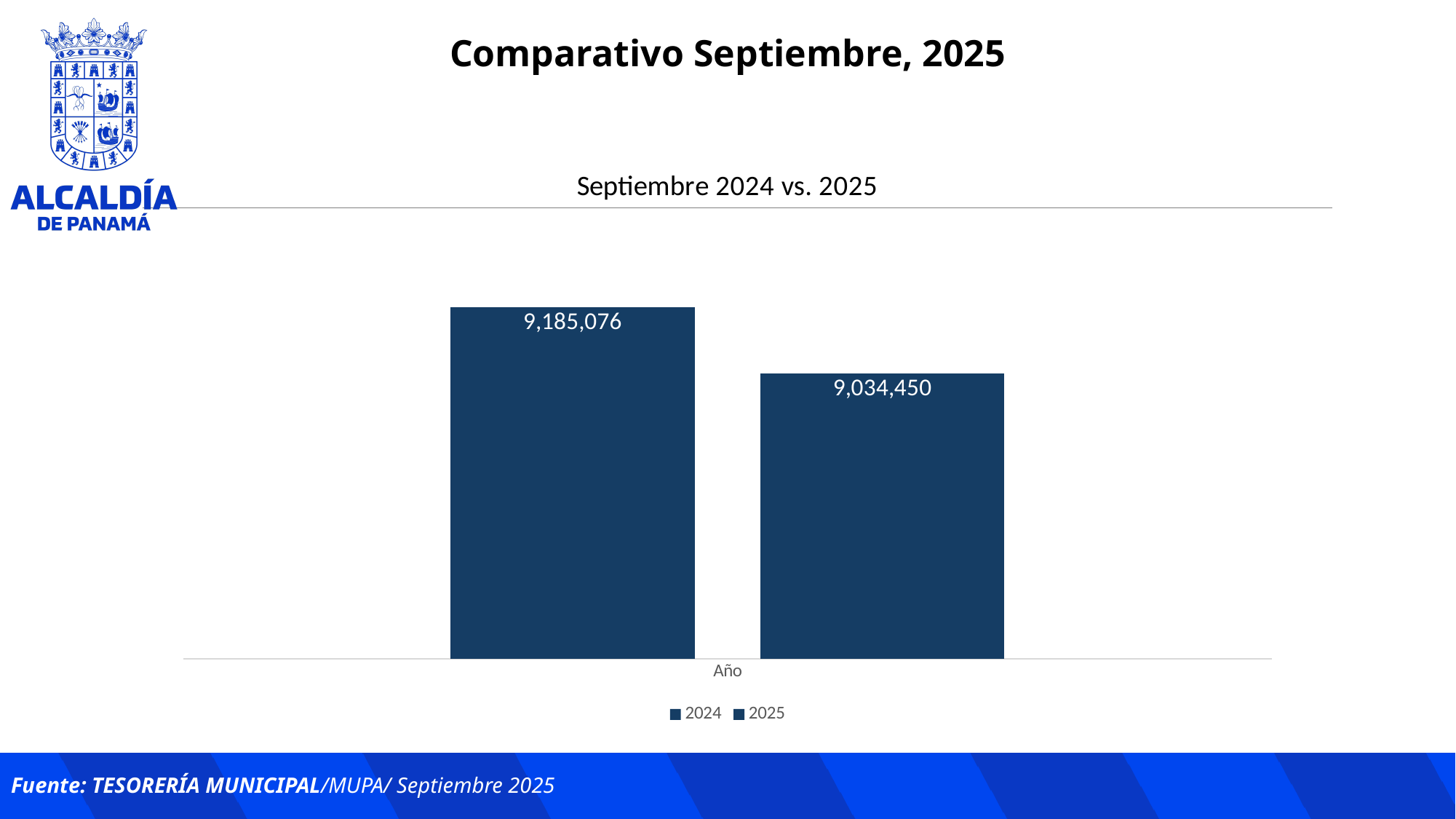
What kind of chart is shown on the slide? Bar chart What is the title of the chart? Septiembre 2024 vs. 2025 Do the values rise or fall from 2024 to 2025? Fall What is the label on the x axis of the chart? Año Which year has the higher value, 2024 or 2025? 2024 What is the value for 2024 in the chart? 9,185,076 Which series has the lowest value in the chart? 2025 How many bars are plotted in the chart? 2 Which series has the highest value in the chart? 2024 How many series does the legend list? 2 What is the value for 2025 in the chart? 9,034,450 What is the difference between the 2024 value and the 2025 value? 150,626